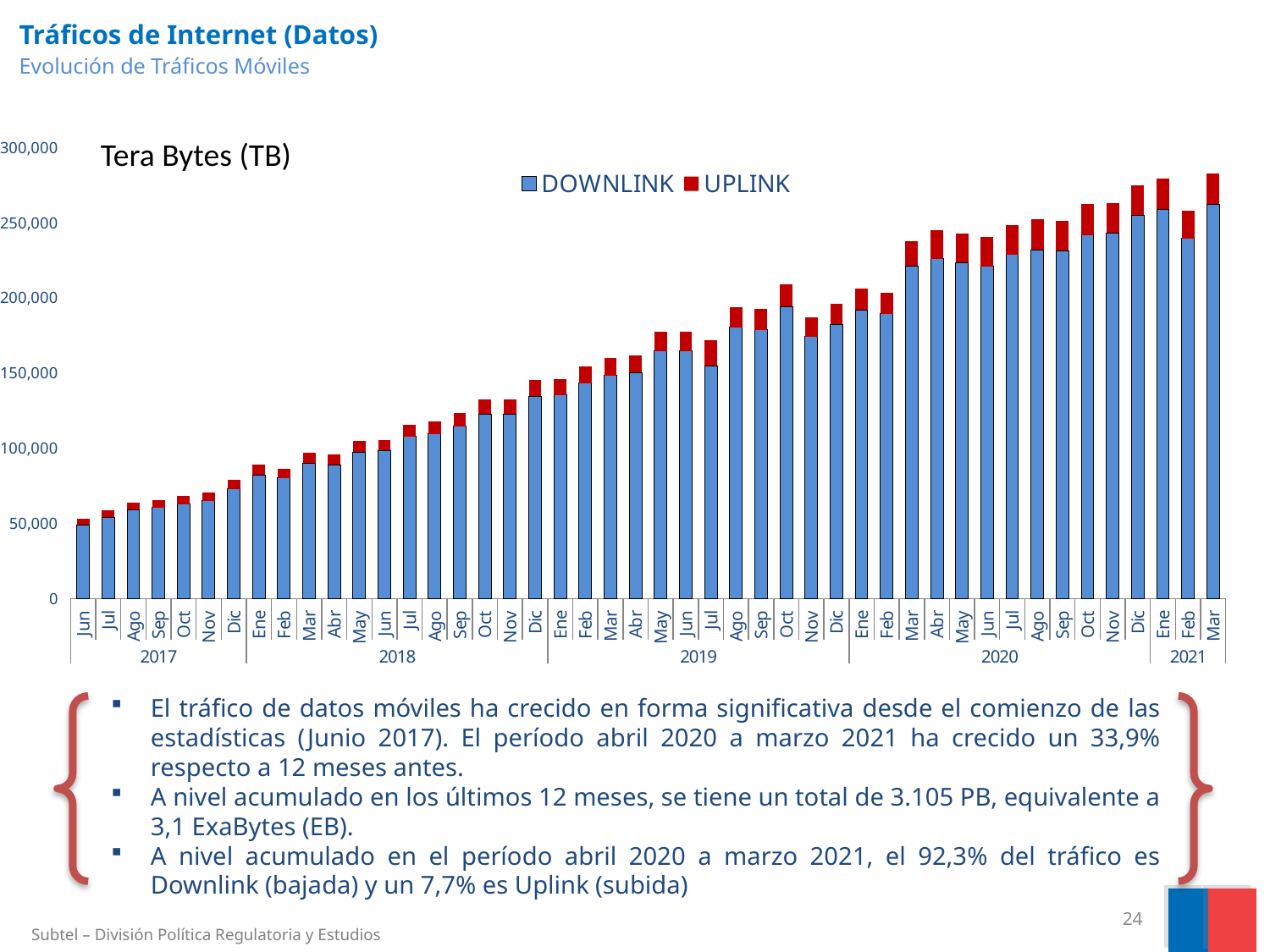
Do the total bar values generally rise or fall from Jun 2017 to Mar 2021? Rise Is the total bar for Jun 2017 greater or less than 100,000? less How many series does the chart legend list? 2 Which month has the highest total bar in the chart? Mar 2021 Which month has the lowest total bar in the chart? Jun 2017 What are the two series named in the chart legend? DOWNLINK and UPLINK Which colour represents the UPLINK series in the chart? Red Is the total bar for Mar 2021 greater or less than 250,000? greater How many monthly bars are plotted in the chart? 46 Which month has the larger total bar, Ene 2021 or Feb 2021? Ene 2021 Is the DOWNLINK value for Mar 2020 greater or less than 200,000? greater What kind of chart is shown on the slide? Stacked bar chart